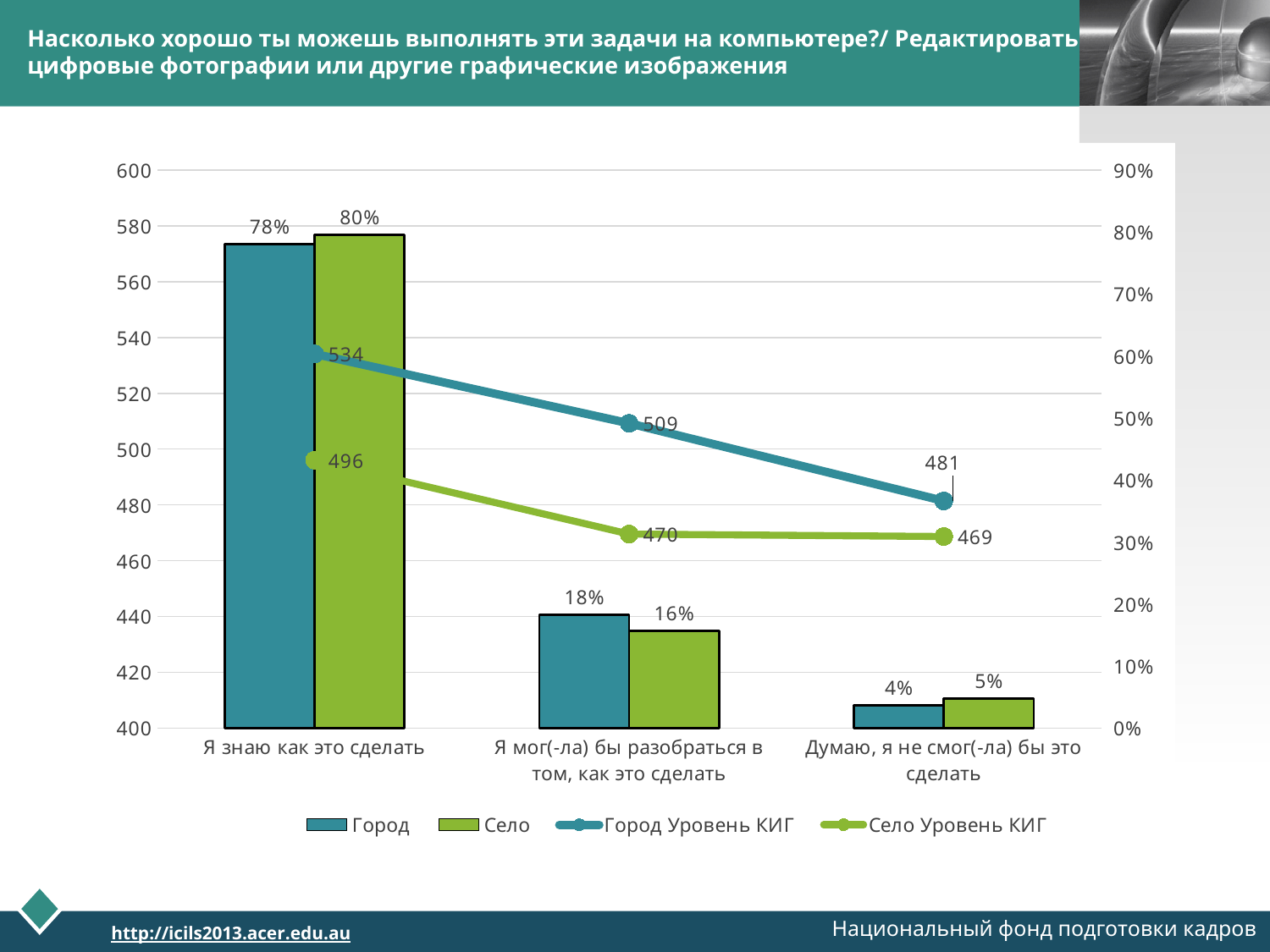
What is the value for Город in the category "Я знаю как это сделать"? 78% What is the difference between the Город Уровень КИГ and Село Уровень КИГ values for "Я знаю как это сделать"? 38 Which category has the highest value for Село? Я знаю как это сделать What is the difference between the Село values for "Я знаю как это сделать" and "Я мог(-ла) бы разобраться в том, как это сделать"? 64% Which is larger for "Я мог(-ла) бы разобраться в том, как это сделать": Город or Село? Город Does the Село Уровень КИГ line rise or fall from the first category to the last? fall Which category has the lowest value on the Город Уровень КИГ line? Думаю, я не смог(-ла) бы это сделать How many categories are shown on the x axis? 3 What is the value for Село in the category "Думаю, я не смог(-ла) бы это сделать"? 5% How many series does the legend list? 4 What is the value of the Город Уровень КИГ line for "Я мог(-ла) бы разобраться в том, как это сделать"? 509 What is the value of the Село Уровень КИГ line for "Я знаю как это сделать"? 496